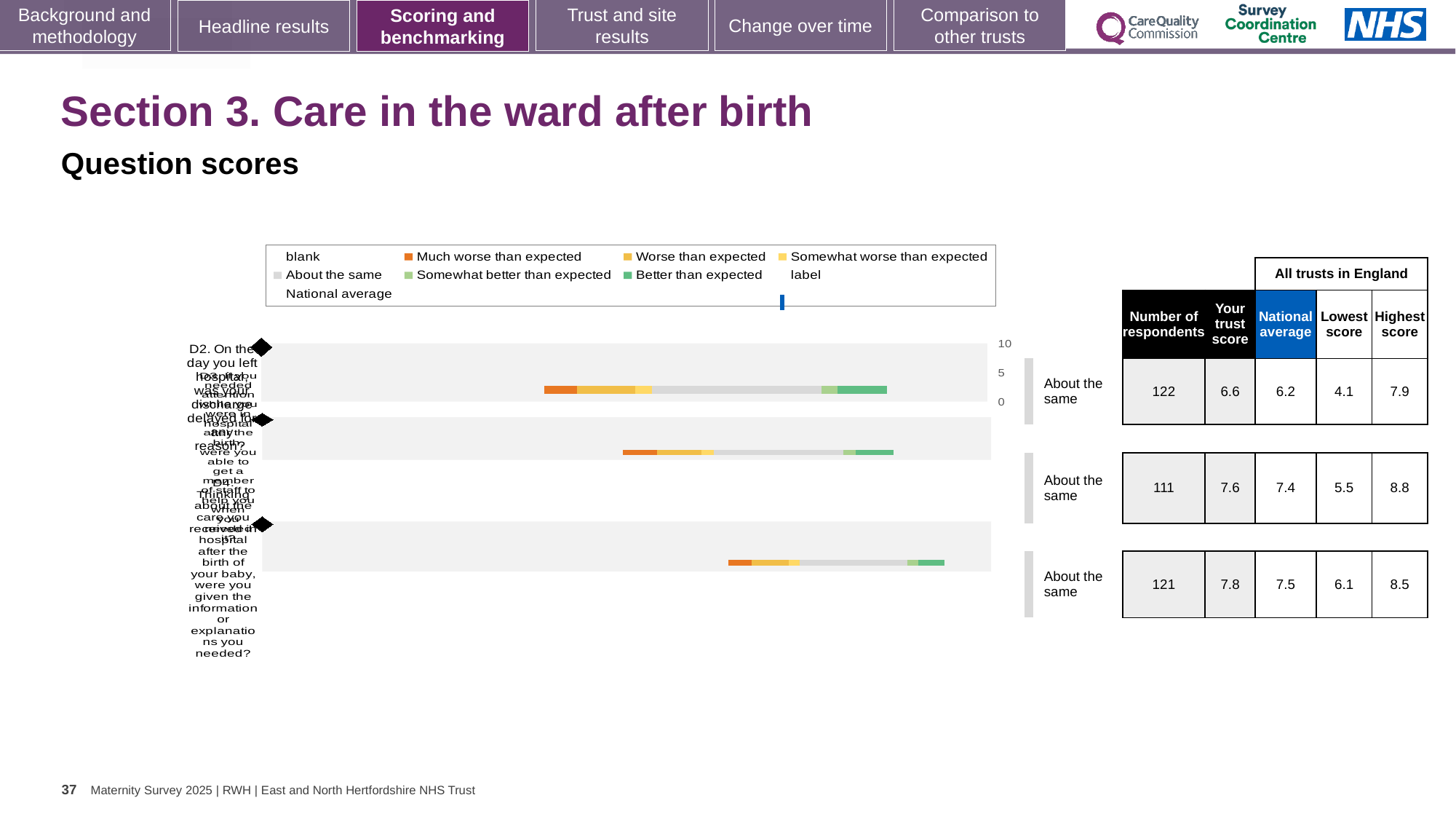
In the chart legend, what colour represents 'Much worse than expected'? orange In the table to the right of the chart, what is the 'Highest score' for the middle row? 8.8 What benchmark label is shown next to each of the three bars in the chart? About the same What kind of chart is shown on the slide? bar chart In the table to the right of the chart, what is the 'National average' for the bottom row? 7.5 In the table to the right of the chart, what is the 'Your trust score' for the top row? 6.6 In the table to the right of the chart, which row has the highest 'Your trust score'? the bottom row (7.8) In the chart legend, what colour represents 'Better than expected'? green In the table to the right of the chart, what is the 'Number of respondents' for the middle row? 111 In the table to the right of the chart, what is the difference between the 'Highest score' and 'Lowest score' for the bottom row? 2.4 In the table to the right of the chart, for the top row, which is larger: 'Your trust score' or 'National average'? Your trust score How many stacked bars are plotted in the chart? 3